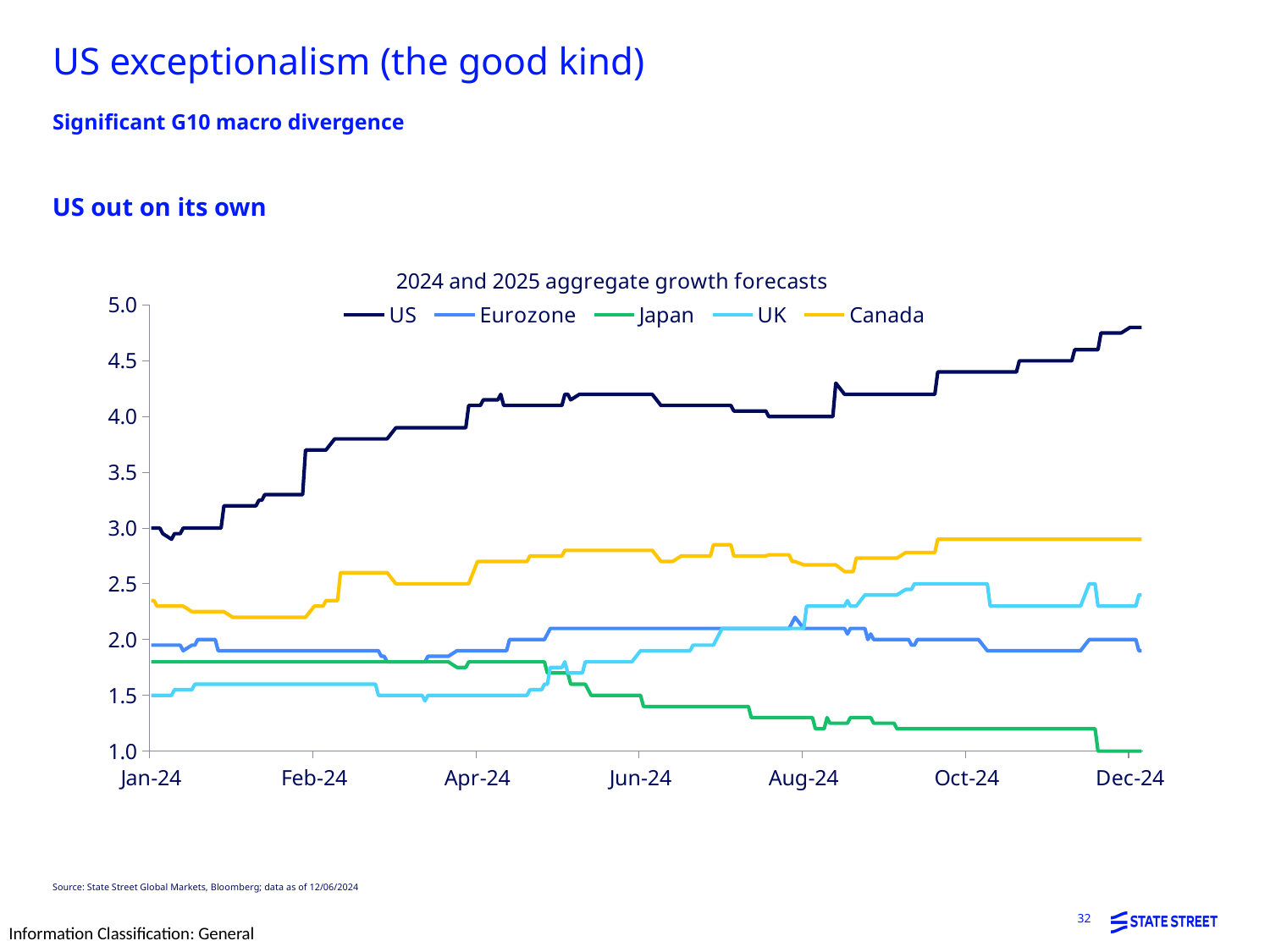
How many series does the legend list? 5 At Dec-24, which is larger, the US value or the Canada value? US Is the value for Japan at Dec-24 greater or less than 1.5? less Does the US line rise or fall from Jan-24 to Dec-24? rise Which series is highest at Dec-24? US Which series is lowest at Dec-24? Japan Is the value for Canada at Dec-24 greater or less than 2.5? greater Is the value for US at Dec-24 greater or less than 4.5? greater Does the Japan line rise or fall from Jan-24 to Dec-24? fall What kind of chart is shown on the slide? line chart Which series is drawn in green? Japan What is the title of the chart? 2024 and 2025 aggregate growth forecasts